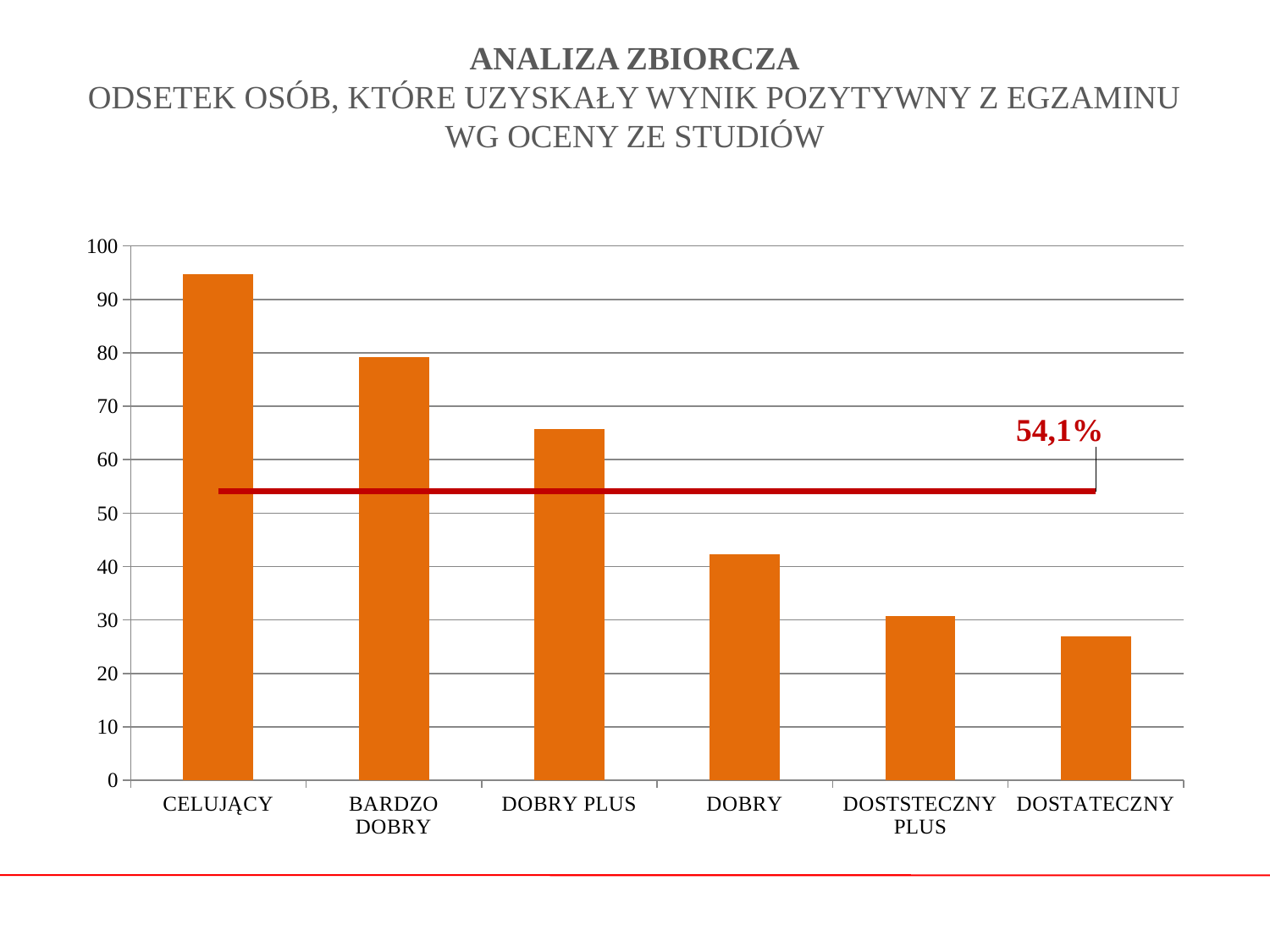
Do the bar values rise or fall from left to right along the x axis? fall What is the bold heading at the top of the slide? ANALIZA ZBIORCZA Is the value for DOBRY greater or less than 50? less Which category has the lowest bar? DOSTATECZNY Which category has the highest bar? CELUJĄCY What value is labelled on the horizontal red reference line in the chart? 54,1% Is the value for CELUJĄCY greater or less than 90? greater Is the value for DOSTATECZNY greater or less than 30? less Which is larger, the value for BARDZO DOBRY or the value for DOBRY? BARDZO DOBRY How many categories are shown on the x axis of the chart? 6 What kind of chart is shown on the slide? bar chart